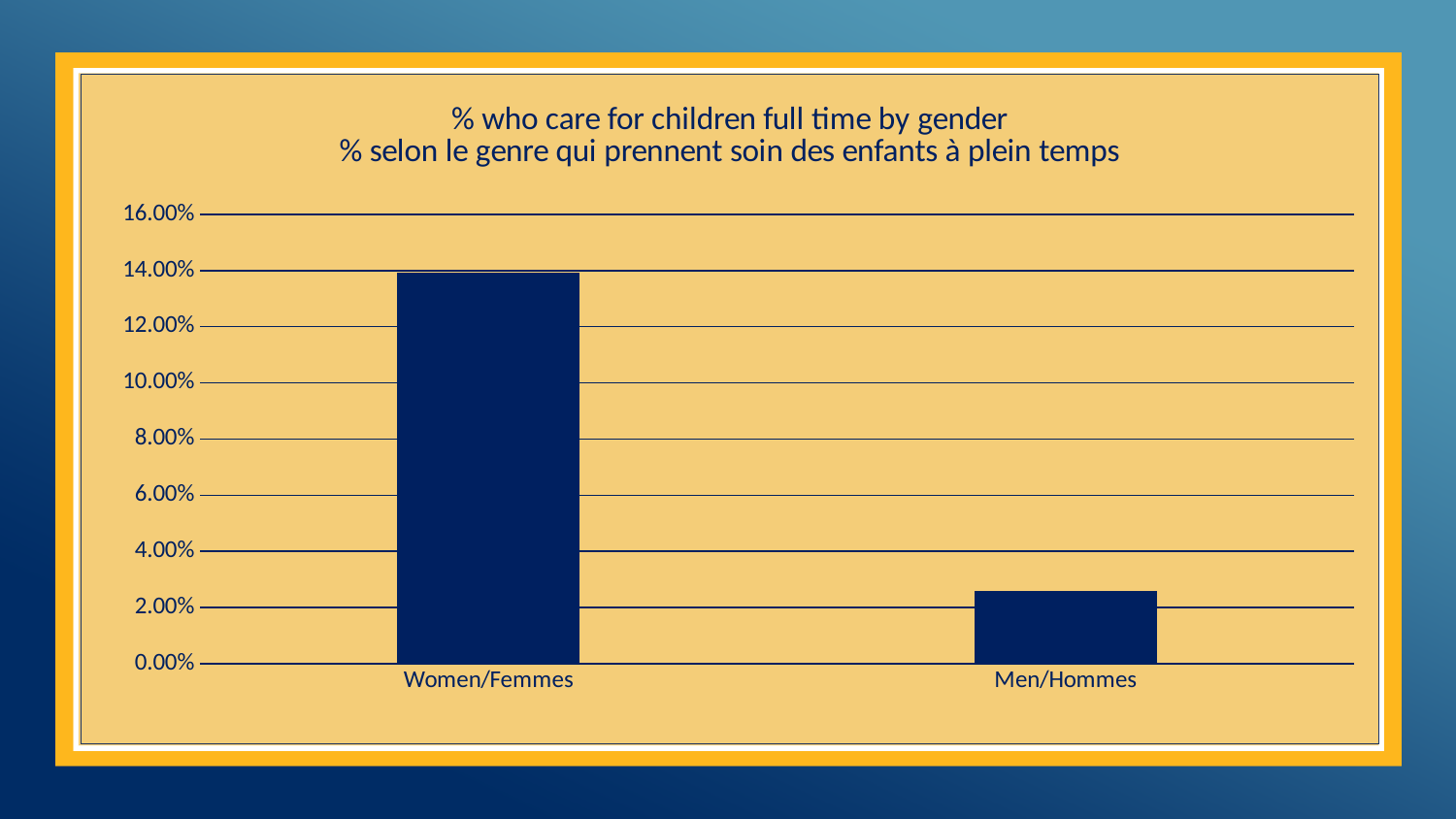
Is the value for Men/Hommes greater or less than 4.00%? less Is the value for Women/Femmes greater or less than 12.00%? greater What is the highest value shown on the vertical axis? 16.00% What is the English title of the chart? % who care for children full time by gender Is the value for Men/Hommes greater or less than 2.00%? greater What kind of chart is shown on the slide? bar chart How many categories are plotted on the chart? 2 Which category has the lowest value? Men/Hommes Which category has the highest value? Women/Femmes Which is larger, the value for Women/Femmes or the value for Men/Hommes? Women/Femmes Do the values rise or fall from left to right along the x axis? fall